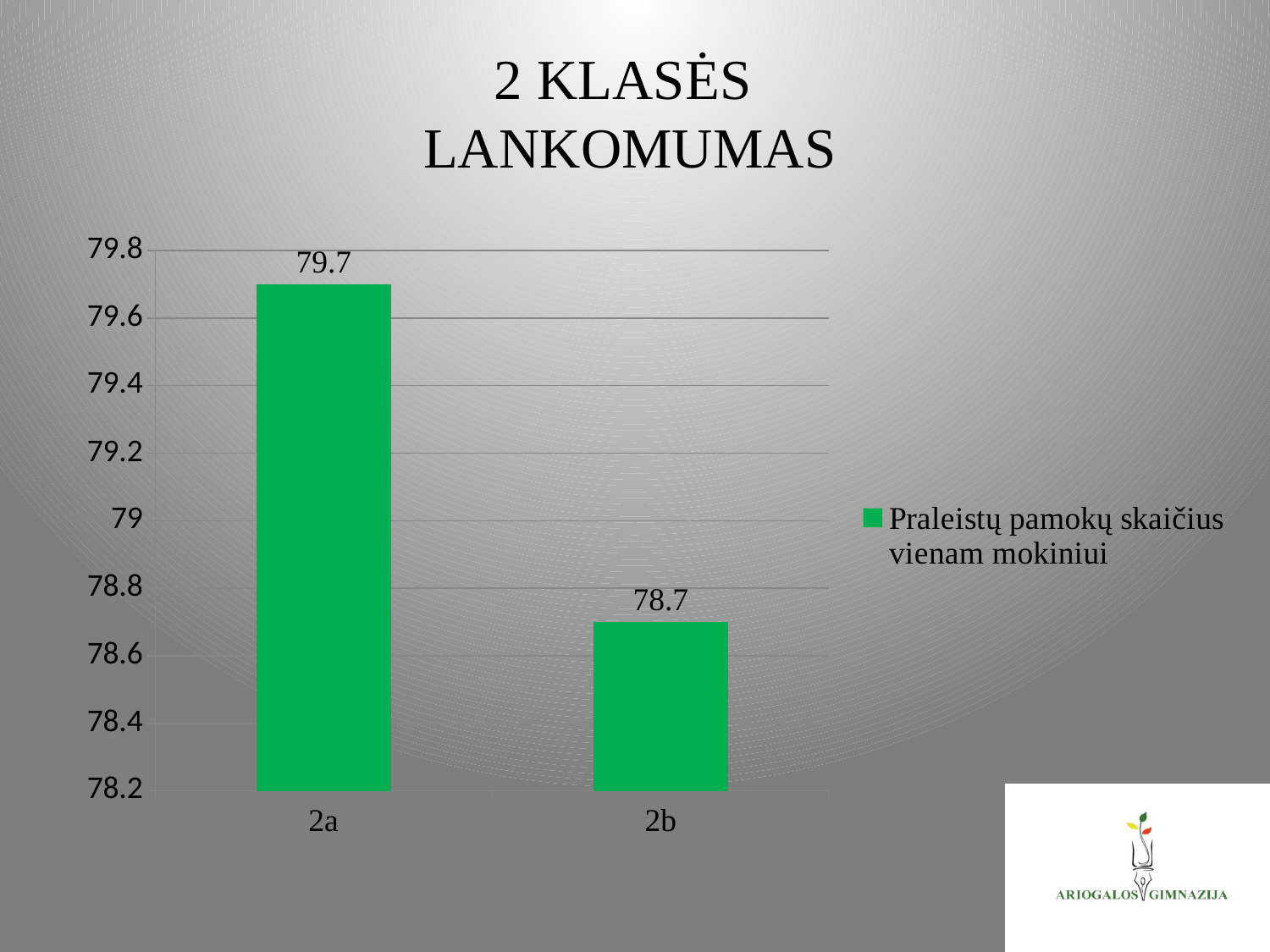
Is the value for 2b greater or less than 79? less What is the legend entry for the series? Praleistų pamokų skaičius vienam mokiniui What is the difference between the values for 2a and 2b? 1 Is the value for 2a greater or less than 79.4? greater How many categories are shown on the x axis? 2 Which is larger, the value for 2a or the value for 2b? 2a What is the value for 2b? 78.7 How many series does the legend list? 1 What kind of chart is shown on the slide? bar chart Which class has the highest value? 2a What is the value for 2a? 79.7 Which class has the lowest value? 2b